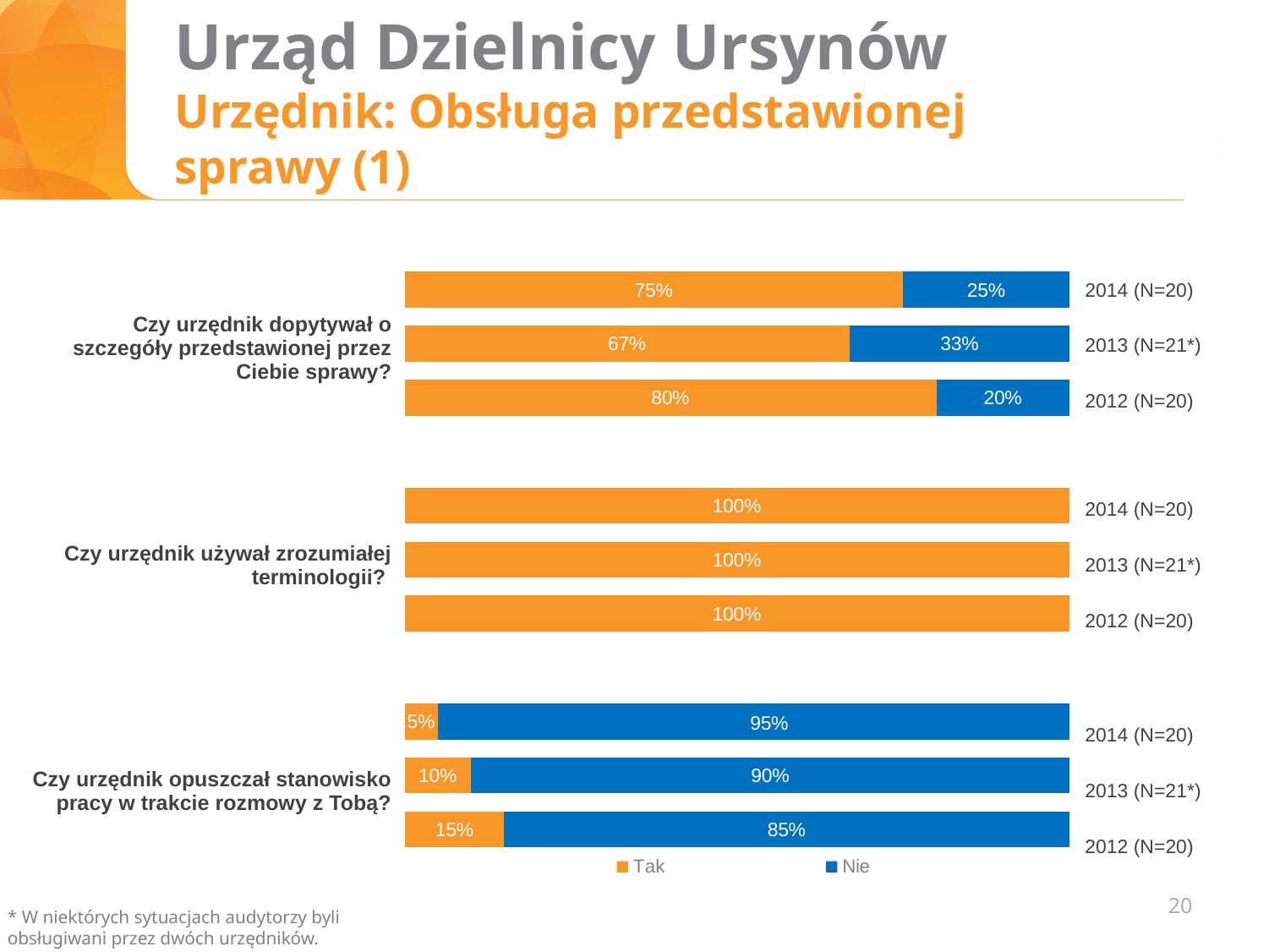
For the question "Czy urzędnik opuszczał stanowisko pracy w trakcie rozmowy z Tobą?", does the "Tak" share rise or fall from 2012 to 2014? Fall Which colour represents the "Nie" answers in the chart? Blue What percentage answered "Nie" in 2013 (N=21*) for the question "Czy urzędnik dopytywał o szczegóły przedstawionej przez Ciebie sprawy?"? 33% What percentage answered "Tak" in 2012 (N=20) for the question "Czy urzędnik używał zrozumiałej terminologii?"? 100% What percentage answered "Tak" in 2014 (N=20) for the question "Czy urzędnik dopytywał o szczegóły przedstawionej przez Ciebie sprawy?"? 75% What kind of chart is shown on the slide? Stacked bar chart How many series does the legend list? 2 For the question "Czy urzędnik opuszczał stanowisko pracy w trakcie rozmowy z Tobą?", is the "Nie" share larger in 2012 (N=20) or in 2013 (N=21*)? 2013 (N=21*) For the question "Czy urzędnik opuszczał stanowisko pracy w trakcie rozmowy z Tobą?", which year has the lowest "Tak" share? 2014 (N=20) For the question "Czy urzędnik dopytywał o szczegóły przedstawionej przez Ciebie sprawy?", which year has the highest "Tak" share? 2012 (N=20) What percentage answered "Nie" in 2014 (N=20) for the question "Czy urzędnik opuszczał stanowisko pracy w trakcie rozmowy z Tobą?"? 95% What is the difference between the "Tak" share in 2012 (N=20) and 2013 (N=21*) for the question "Czy urzędnik dopytywał o szczegóły przedstawionej przez Ciebie sprawy?"? 13 percentage points